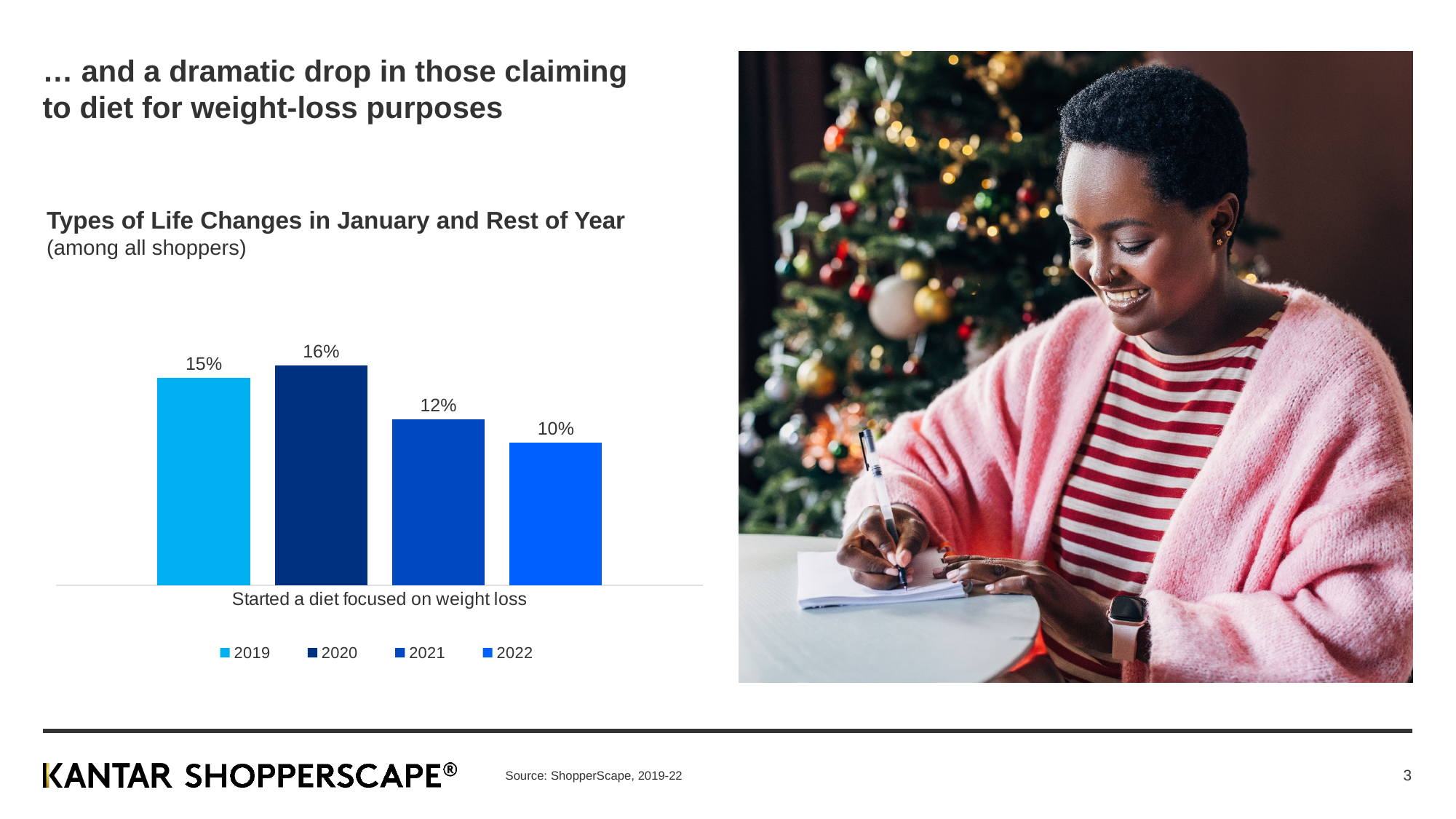
What is the title of the chart on the slide? Types of Life Changes in January and Rest of Year What percentage of shoppers started a diet focused on weight loss in 2019? 15% From 2020 to 2022, do the values for starting a diet focused on weight loss rise or fall? Fall How many years (series) does the chart legend list? 4 Which year has the highest share of shoppers who started a diet focused on weight loss? 2020 What is the difference in percentage points between the 2020 and 2022 values for starting a diet focused on weight loss? 6 percentage points What percentage of shoppers started a diet focused on weight loss in 2020? 16% Which year has the lowest share of shoppers who started a diet focused on weight loss? 2022 What type of chart is shown on the slide? Bar chart Which year had a larger share of shoppers starting a weight-loss diet, 2019 or 2021? 2019 What percentage of shoppers started a diet focused on weight loss in 2022? 10% What percentage of shoppers started a diet focused on weight loss in 2021? 12%